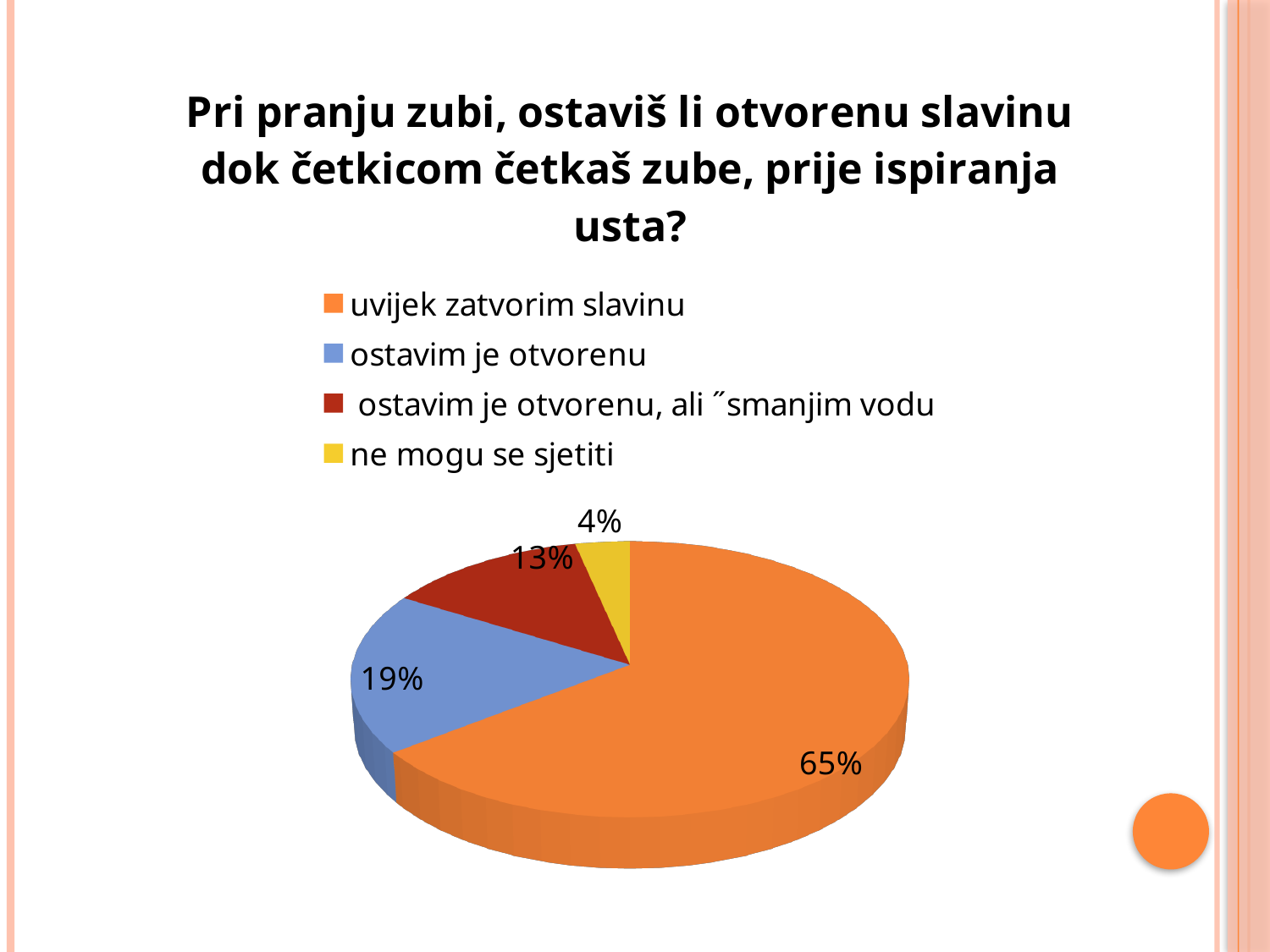
Which is larger: the share for "ostavim je otvorenu" or the share for "ostavim je otvorenu, ali smanjim vodu"? ostavim je otvorenu How many categories does the pie chart have? 4 How many entries does the legend list? 4 Which category has the smallest slice of the pie? ne mogu se sjetiti Which category has the largest slice of the pie? uvijek zatvorim slavinu What share of the pie does "ne mogu se sjetiti" have? 4% What share of the pie does "uvijek zatvorim slavinu" have? 65% What share of the pie does "ostavim je otvorenu, ali smanjim vodu" have? 13% What is the difference between the shares for "uvijek zatvorim slavinu" and "ostavim je otvorenu"? 46% What kind of chart is shown on the slide? pie chart What colour is the slice for "ne mogu se sjetiti"? yellow